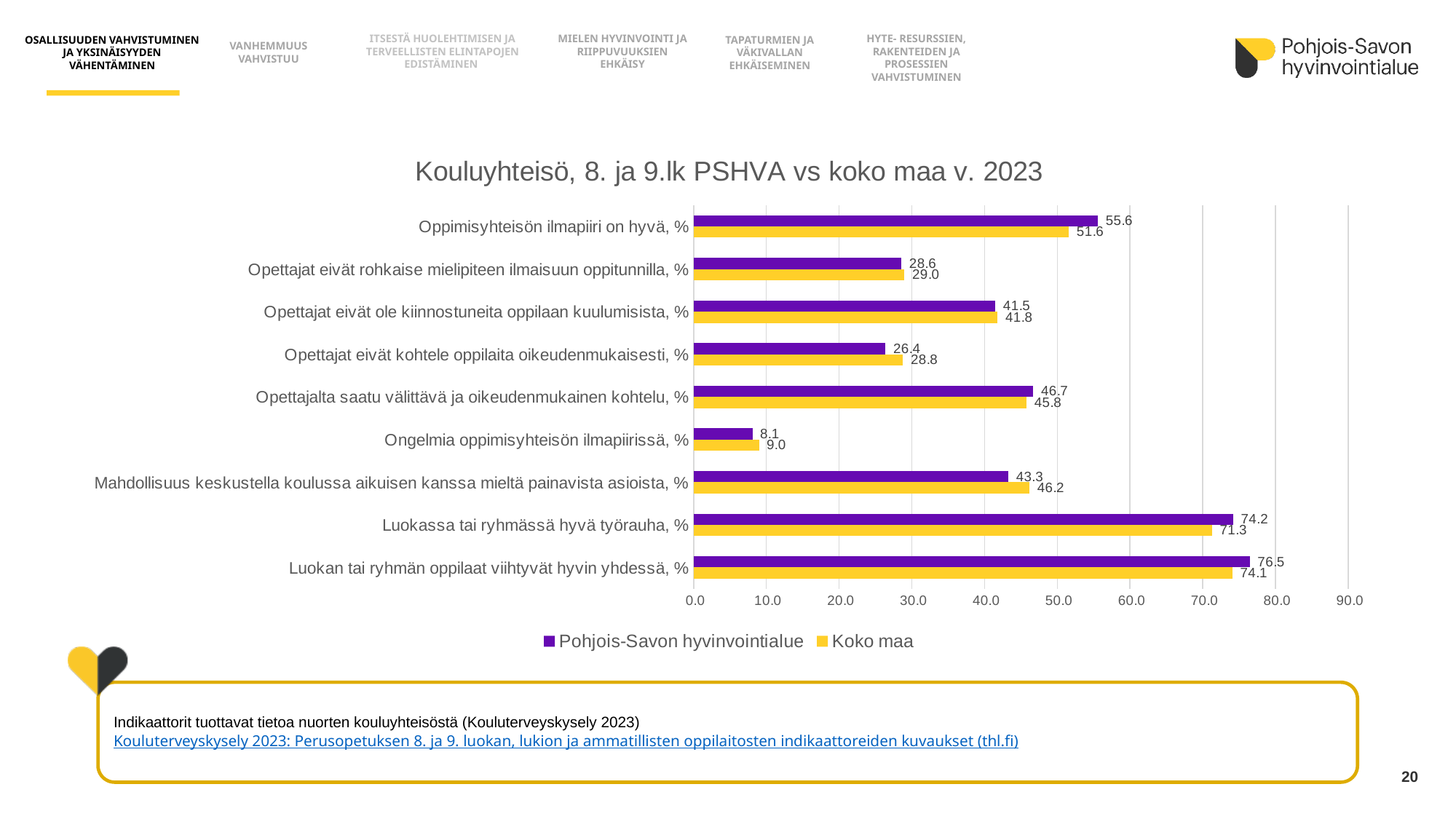
What is the value for Pohjois-Savon hyvinvointialue for "Oppimisyhteisön ilmapiiri on hyvä, %"? 55.6 How many series does the legend list? 2 What is the difference between the Koko maa and Pohjois-Savon hyvinvointialue values for "Mahdollisuus keskustella koulussa aikuisen kanssa mieltä painavista asioista, %"? 2.9 What is the value for Koko maa for "Ongelmia oppimisyhteisön ilmapiirissä, %"? 9.0 Is the Pohjois-Savon hyvinvointialue value for "Luokassa tai ryhmässä hyvä työrauha, %" greater or less than 70.0? greater Which category has the highest value for Pohjois-Savon hyvinvointialue? Luokan tai ryhmän oppilaat viihtyvät hyvin yhdessä, % How many categories are shown on the chart? 9 For "Opettajat eivät kohtele oppilaita oikeudenmukaisesti, %", which is larger: Pohjois-Savon hyvinvointialue or Koko maa? Koko maa Which category has the lowest value for Koko maa? Ongelmia oppimisyhteisön ilmapiirissä, % What is the value for Koko maa for "Luokassa tai ryhmässä hyvä työrauha, %"? 71.3 What is the difference between the Pohjois-Savon hyvinvointialue and Koko maa values for "Oppimisyhteisön ilmapiiri on hyvä, %"? 4.0 What kind of chart is shown on the slide? Bar chart